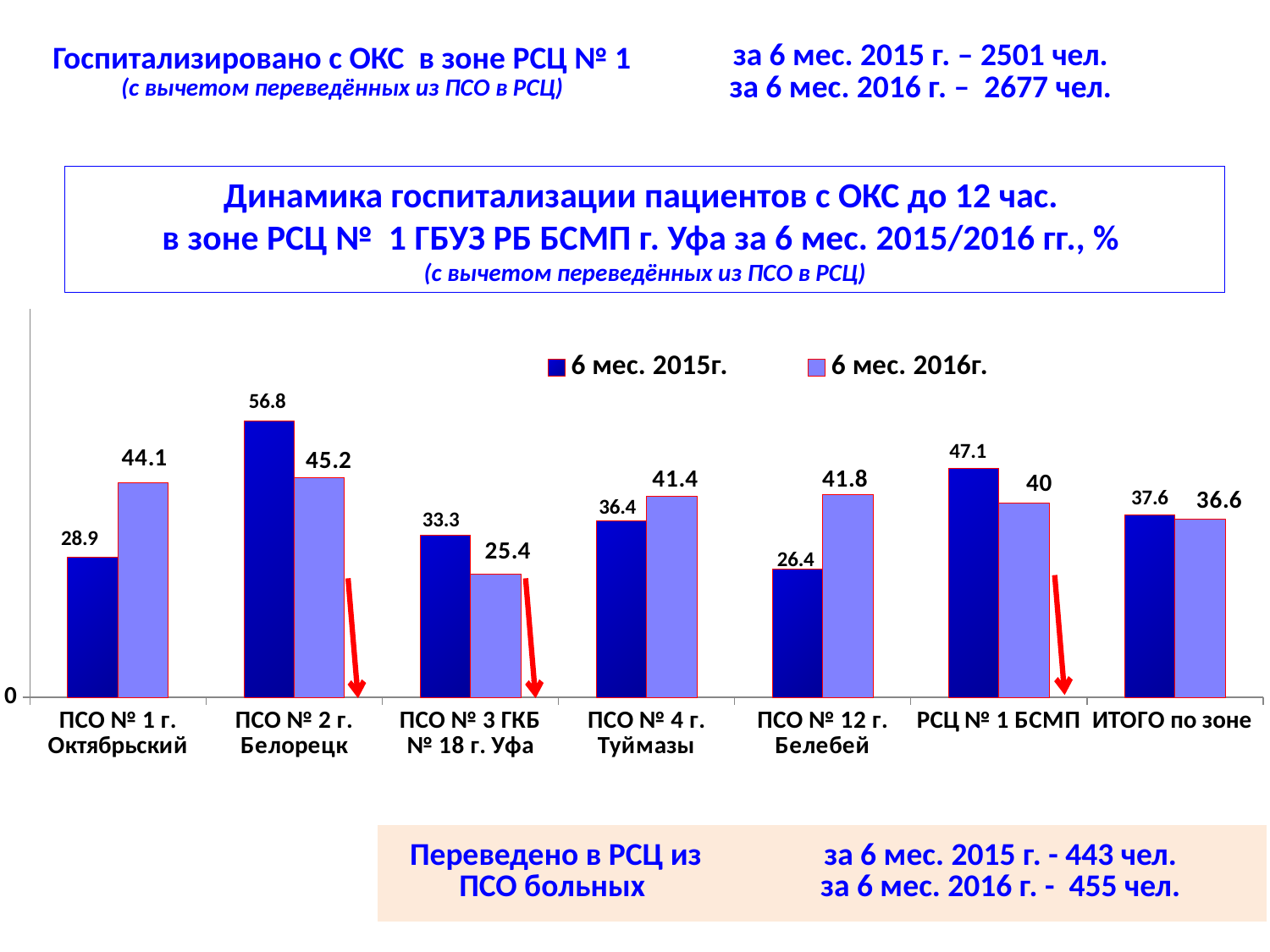
Which category has the lowest value in the 6 мес. 2016г. series? ПСО № 3 ГКБ № 18 г. Уфа What is the value for ИТОГО по зоне in the 6 мес. 2015г. series? 37.6 What is the value for ПСО № 2 г. Белорецк in the 6 мес. 2015г. series? 56.8 For ПСО № 4 г. Туймазы, which series has the larger value: 6 мес. 2015г. or 6 мес. 2016г.? 6 мес. 2016г. How many series does the legend list? 2 What kind of chart is shown on the slide? bar chart What is the difference between the 6 мес. 2016г. and 6 мес. 2015г. values for ПСО № 1 г. Октябрьский? 15.2 Which series is shown in dark blue in the legend? 6 мес. 2015г. Which category has the highest value in the 6 мес. 2015г. series? ПСО № 2 г. Белорецк What is the value for ПСО № 12 г. Белебей in the 6 мес. 2016г. series? 41.8 What is the value for РСЦ № 1 БСМП in the 6 мес. 2016г. series? 40 How many categories are shown on the x axis of the chart? 7